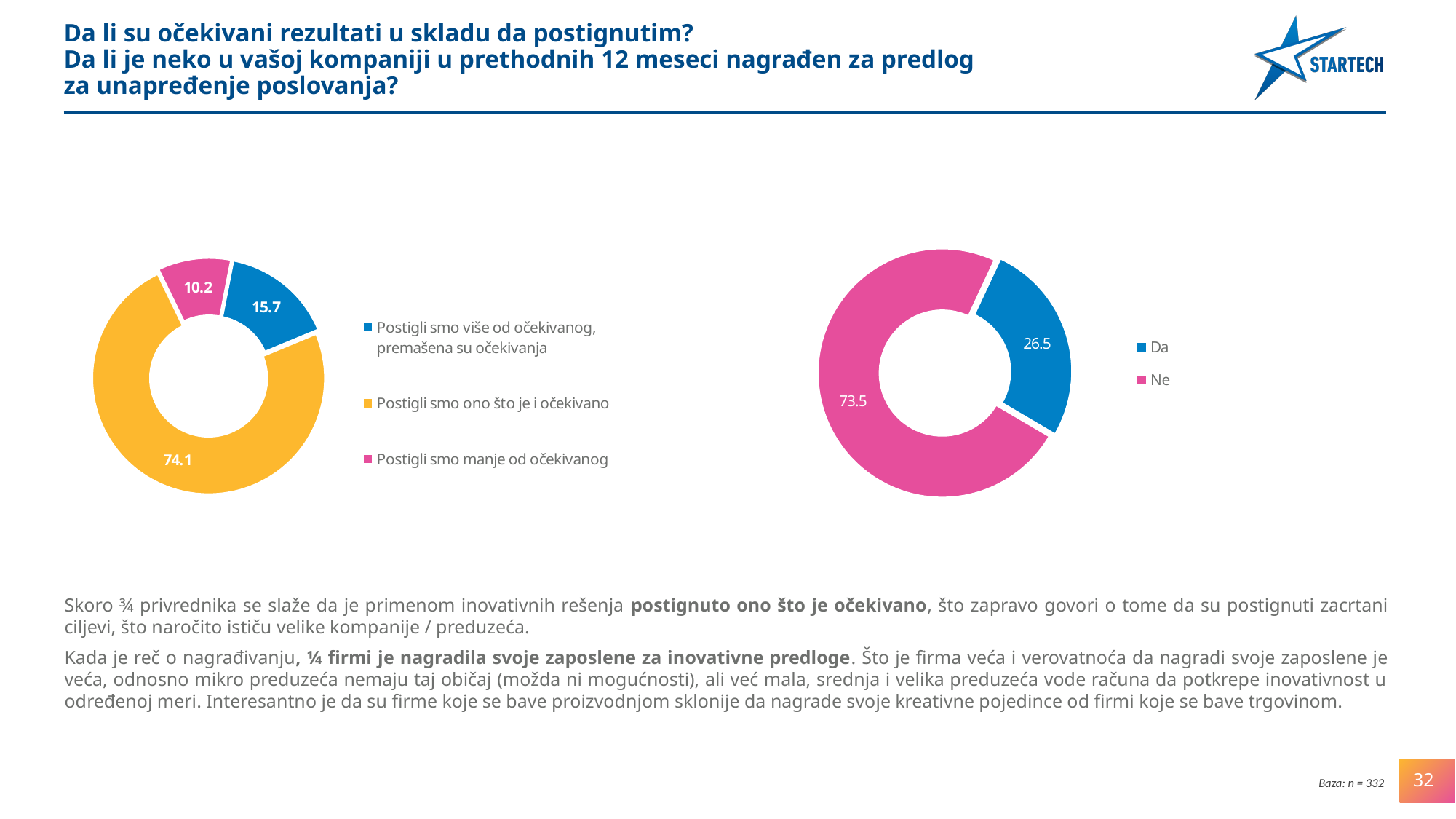
On the left chart, which category has the largest share? Postigli smo ono što je i očekivano On the right chart, what is the difference between "Ne" and "Da"? 47 On the right chart, what is the value for "Da"? 26.5 What type of chart is the right chart? Doughnut chart On the left chart, what is the value for "Postigli smo ono što je i očekivano"? 74.1 On the left chart, what is the value for "Postigli smo više od očekivanog, premašena su očekivanja"? 15.7 On the left chart, how many categories are shown? 3 On the left chart, what is the value for "Postigli smo manje od očekivanog"? 10.2 On the right chart, what is the value for "Ne"? 73.5 On the left chart, what is the difference between "Postigli smo više od očekivanog, premašena su očekivanja" and "Postigli smo manje od očekivanog"? 5.5 On the left chart, which category has the smallest share? Postigli smo manje od očekivanog On the right chart, which is larger, "Da" or "Ne"? Ne